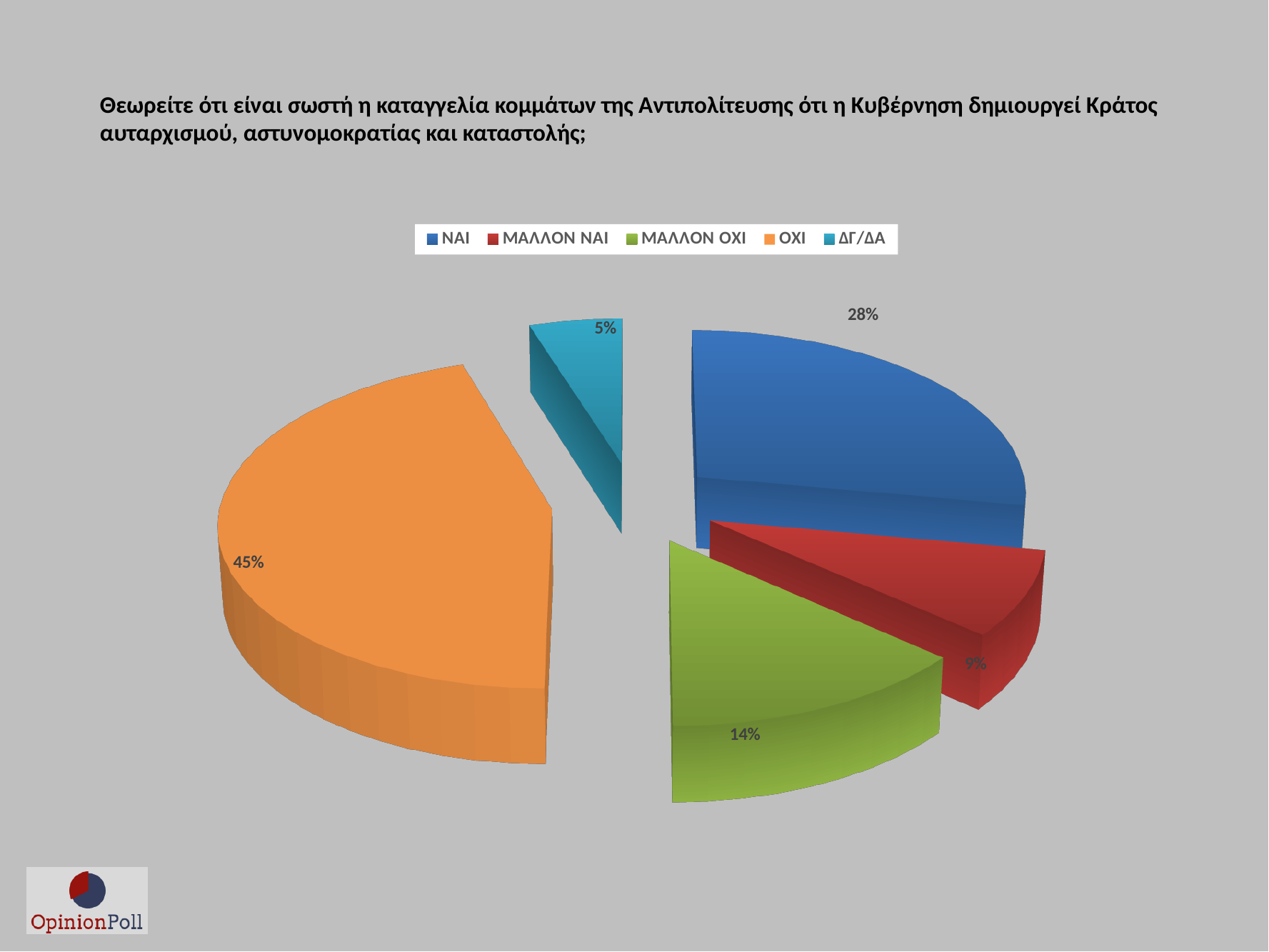
Which response has the smallest share of the pie? ΔΓ/ΔΑ What percentage of respondents answered ΔΓ/ΔΑ? 5% What colour is the ΟΧΙ slice? orange How many categories does the legend list? 5 What is the difference in percentage points between ΟΧΙ and ΝΑΙ? 17 What kind of chart is shown on the slide? pie chart Which is larger, the share for ΜΑΛΛΟΝ ΟΧΙ or the share for ΜΑΛΛΟΝ ΝΑΙ? ΜΑΛΛΟΝ ΟΧΙ Which response has the largest share of the pie? ΟΧΙ What percentage of respondents answered ΟΧΙ? 45% What percentage of respondents answered ΜΑΛΛΟΝ ΝΑΙ? 9% What percentage of respondents answered ΝΑΙ? 28% What percentage of respondents answered ΜΑΛΛΟΝ ΟΧΙ? 14%